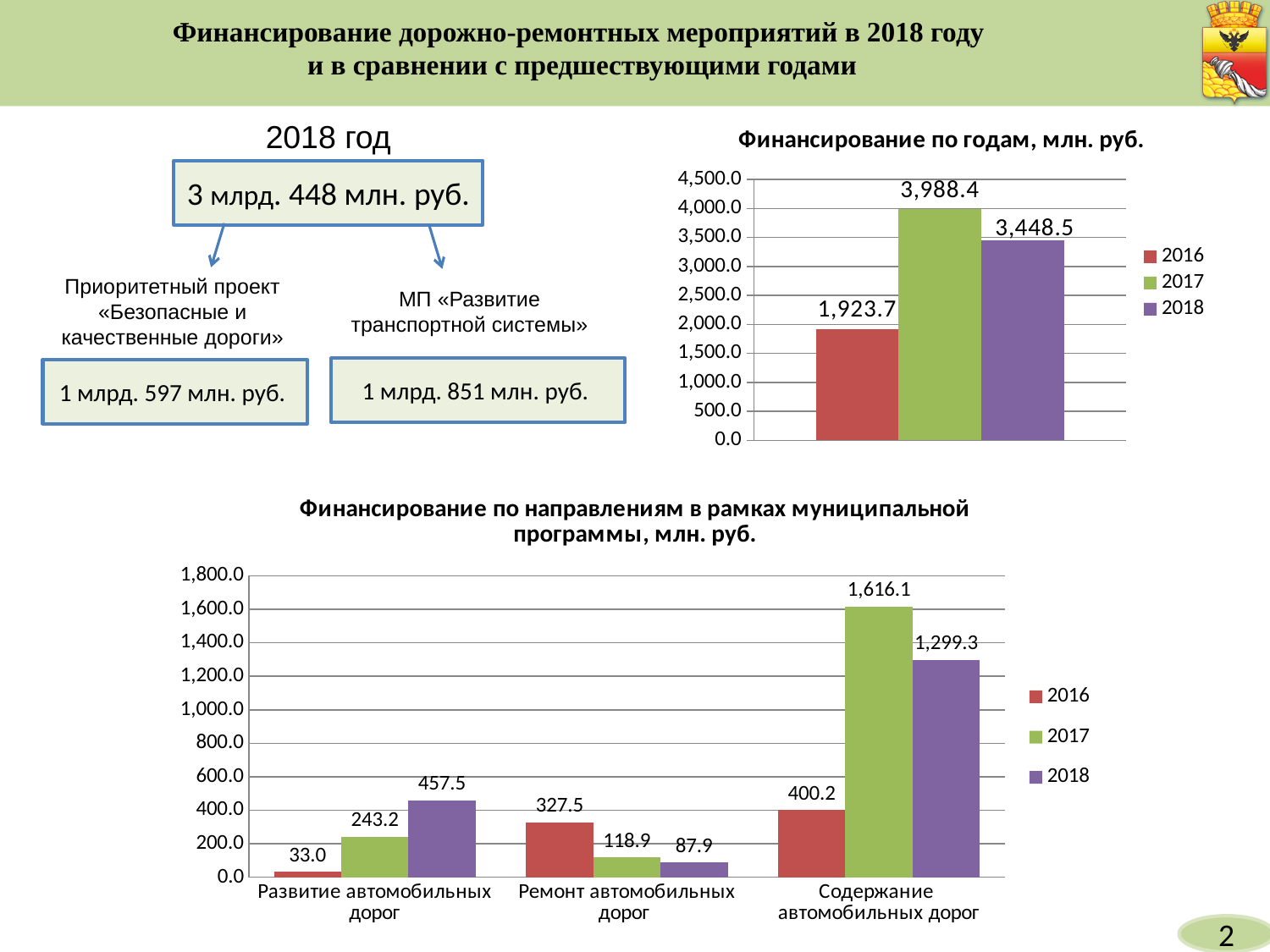
In the chart 'Финансирование по направлениям в рамках муниципальной программы, млн. руб.', which category has the highest 2017 value? Содержание автомобильных дорог In the chart 'Финансирование по направлениям в рамках муниципальной программы, млн. руб.', do the values for 'Ремонт автомобильных дорог' rise or fall from 2016 to 2018? fall In the chart 'Финансирование по годам, млн. руб.', what is the difference between the 2017 and 2018 values? 539.9 In the chart 'Финансирование по годам, млн. руб.', how many series does the legend list? 3 In the chart 'Финансирование по направлениям в рамках муниципальной программы, млн. руб.', how many categories are shown on the x axis? 3 In the chart 'Финансирование по годам, млн. руб.', which year has the lowest value? 2016 In the chart 'Финансирование по направлениям в рамках муниципальной программы, млн. руб.', which is larger for 'Содержание автомобильных дорог': the 2017 value or the 2018 value? 2017 In the chart 'Финансирование по годам, млн. руб.', what is the value for 2017? 3,988.4 In the chart 'Финансирование по направлениям в рамках муниципальной программы, млн. руб.', what is the difference between the 2017 and 2018 values for 'Содержание автомобильных дорог'? 316.8 What kind of chart is 'Финансирование по годам, млн. руб.'? bar chart In the chart 'Финансирование по направлениям в рамках муниципальной программы, млн. руб.', what is the 2018 value for 'Развитие автомобильных дорог'? 457.5 In the chart 'Финансирование по направлениям в рамках муниципальной программы, млн. руб.', what is the 2016 value for 'Ремонт автомобильных дорог'? 327.5